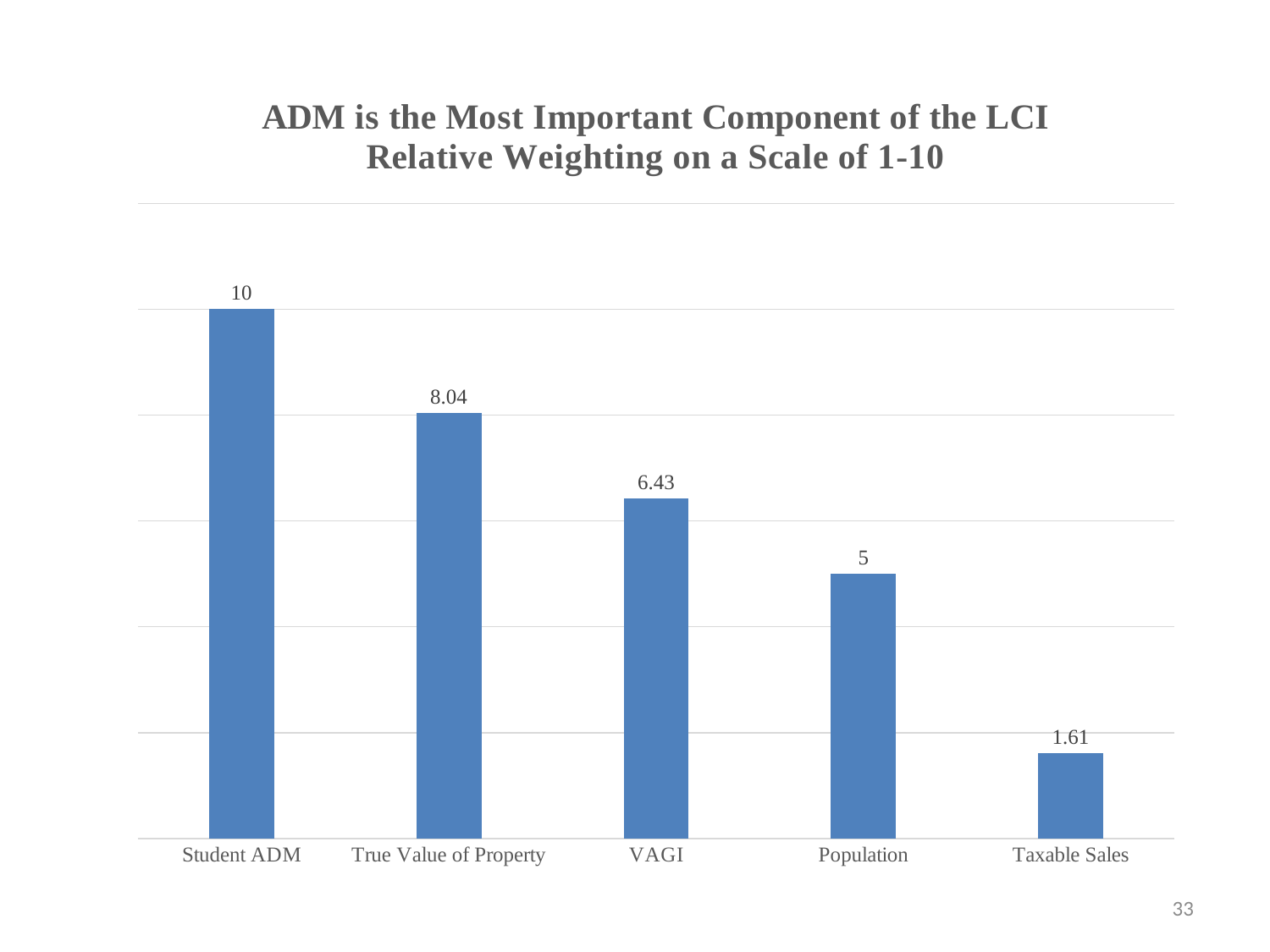
How many components are shown in the chart? 5 What is the difference between the values for True Value of Property and VAGI? 1.61 What is the relative weighting value for Student ADM? 10 Which component has the highest relative weighting? Student ADM What is the relative weighting value for True Value of Property? 8.04 What is the relative weighting value for Taxable Sales? 1.61 Which has a larger value, VAGI or Population? VAGI Do the values rise or fall from left to right across the categories? Fall What is the relative weighting value for VAGI? 6.43 What is the difference between the values for Student ADM and Population? 5 Which component has the lowest relative weighting? Taxable Sales What kind of chart is shown on the slide? Bar chart